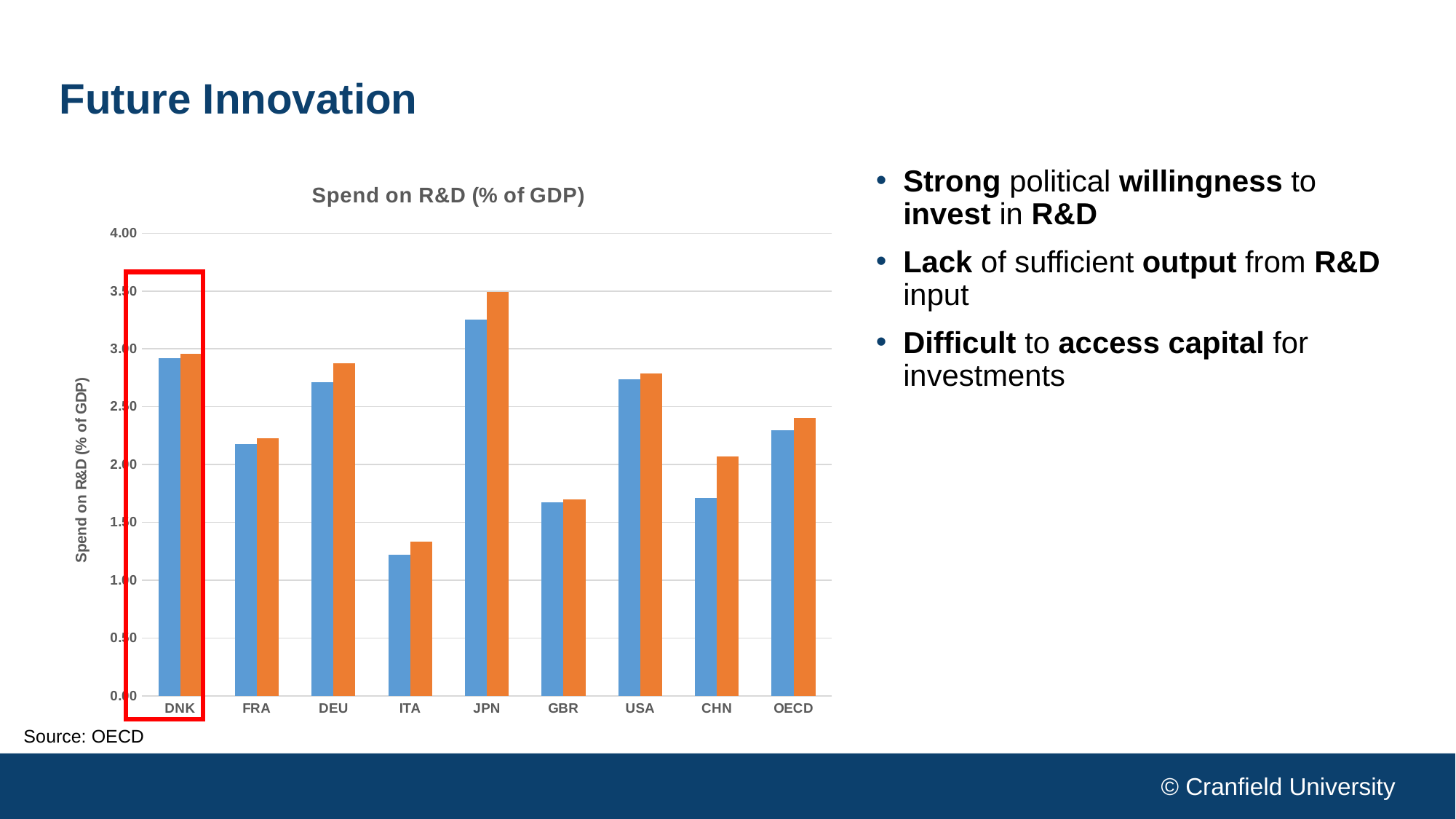
What is the title of the chart? Spend on R&D (% of GDP) Which category has the highest R&D spend as a share of GDP in the chart? JPN Is the blue bar for GBR greater or less than 1.50? greater Which has a higher R&D spend as a share of GDP, DNK or FRA? DNK Is the blue bar for USA greater or less than 2.50? greater What kind of chart is shown on the slide? Bar chart Which category on the chart is highlighted with a red box? DNK Which has a higher R&D spend as a share of GDP, CHN or DEU? DEU Is the blue bar for ITA greater or less than 1.50? less How many countries or groups are shown on the x axis of the chart? 9 Which category has the lowest R&D spend as a share of GDP in the chart? ITA